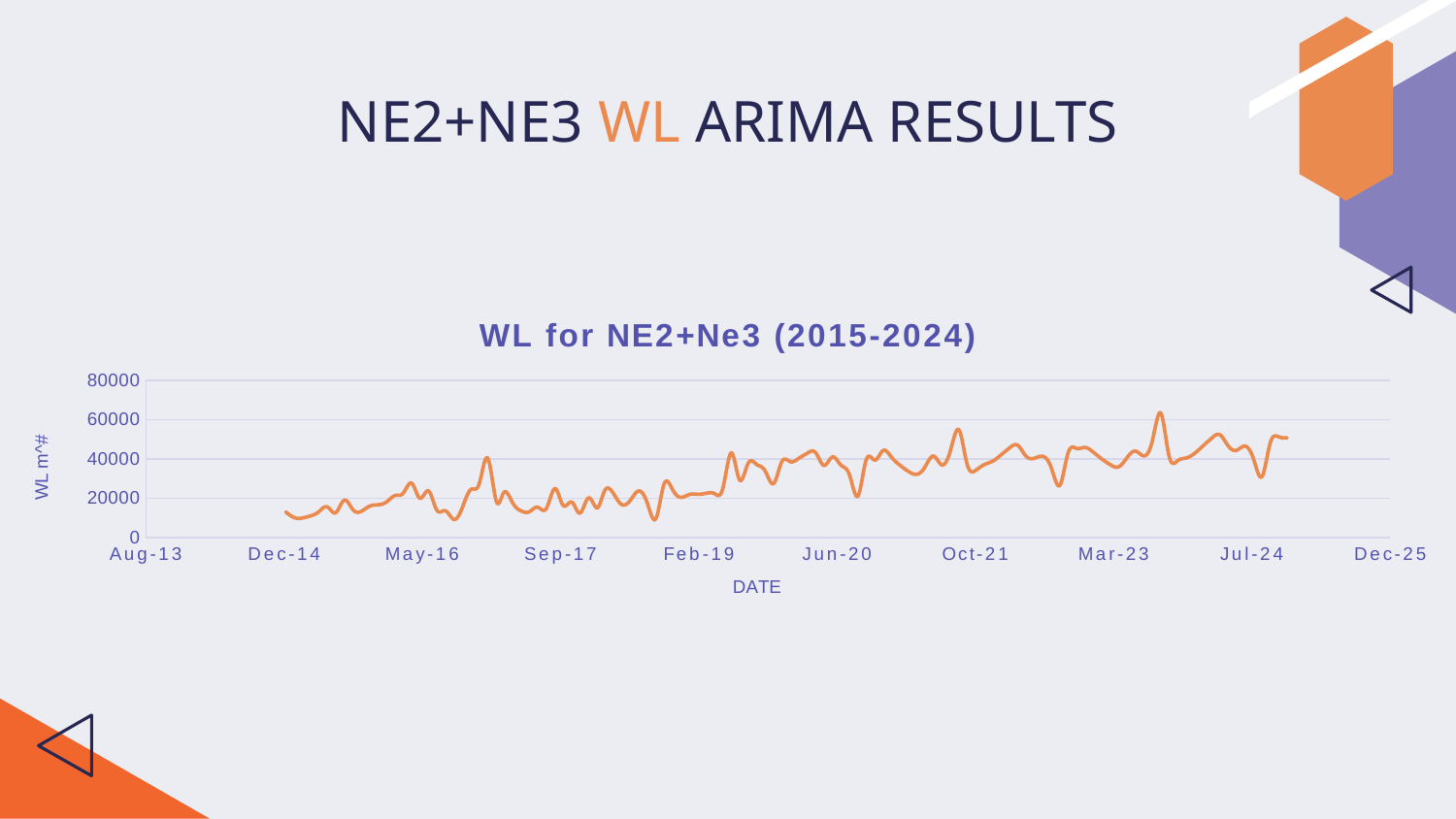
What is the title of the chart? WL for NE2+Ne3 (2015-2024) Is the WL value around Jul-24 greater or less than 40000? greater What is the label of the x axis of the chart? DATE Is the highest WL value on the chart greater or less than 80000? less Is the WL value at the start of the series (just after Dec-14) greater or less than 20000? less How many tick labels are shown on the x axis of the chart? 10 Overall, do the WL values rise or fall from the start of the series to the end? rise What is the highest tick value shown on the y axis of the chart? 80000 What kind of chart is shown on the slide? line chart